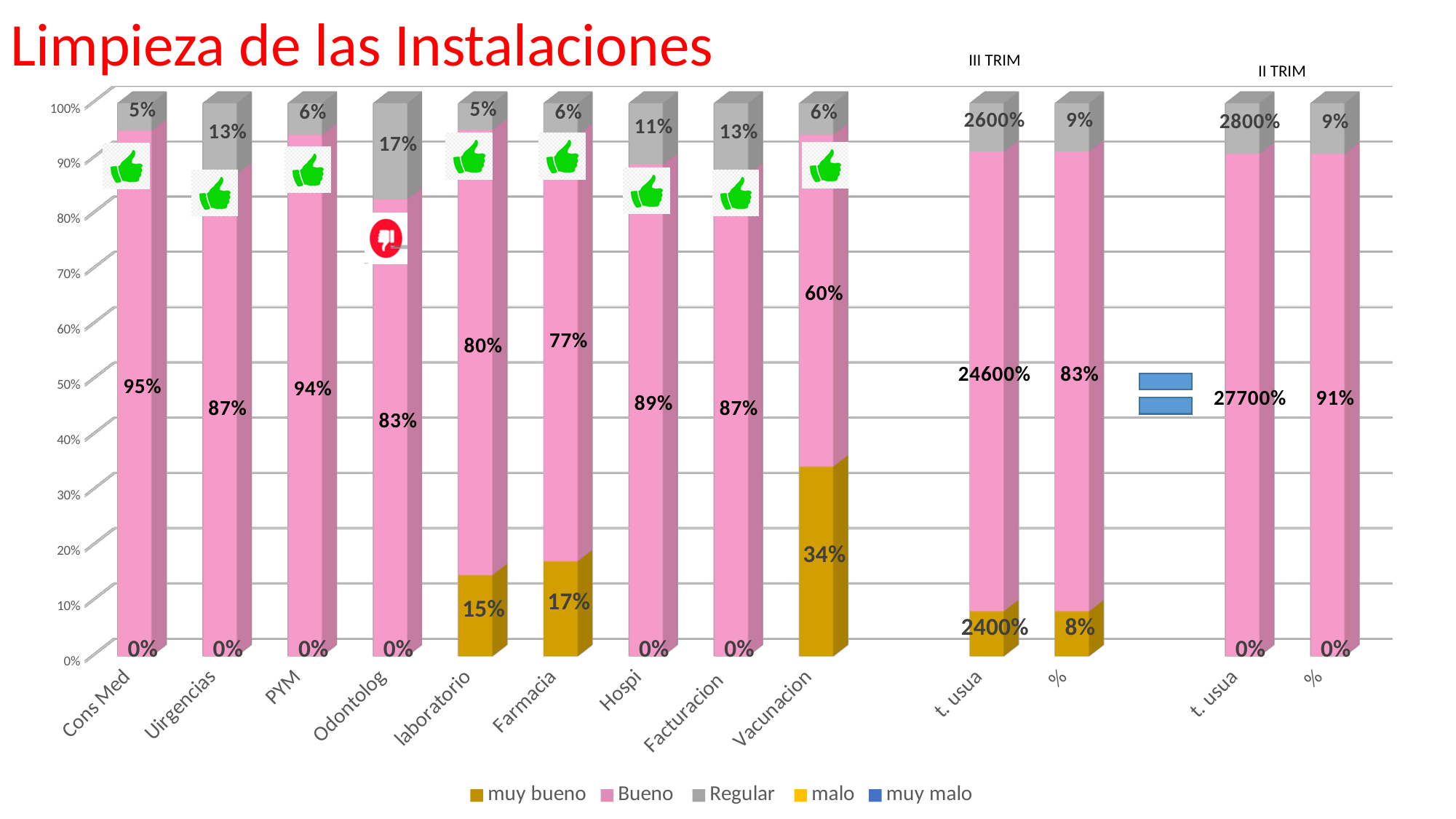
What is the muy bueno value for Vacunacion? 34% What is the Bueno value for Farmacia? 77% Which category has the lowest Bueno value among the first nine categories (Cons Med through Vacunacion)? Vacunacion How many series does the legend list? 5 What is the title of the slide's chart? Limpieza de las Instalaciones Which category has the highest Bueno value among the first nine categories (Cons Med through Vacunacion)? Cons Med What is the Bueno value for Cons Med? 95% What is the muy bueno value for laboratorio? 15% What is the difference between the Bueno values for Cons Med and Uirgencias? 8% Which has a larger Regular value, Hospi or PYM? Hospi What is the Regular value for Odontolog? 17% What kind of chart is shown on the slide? Stacked bar chart